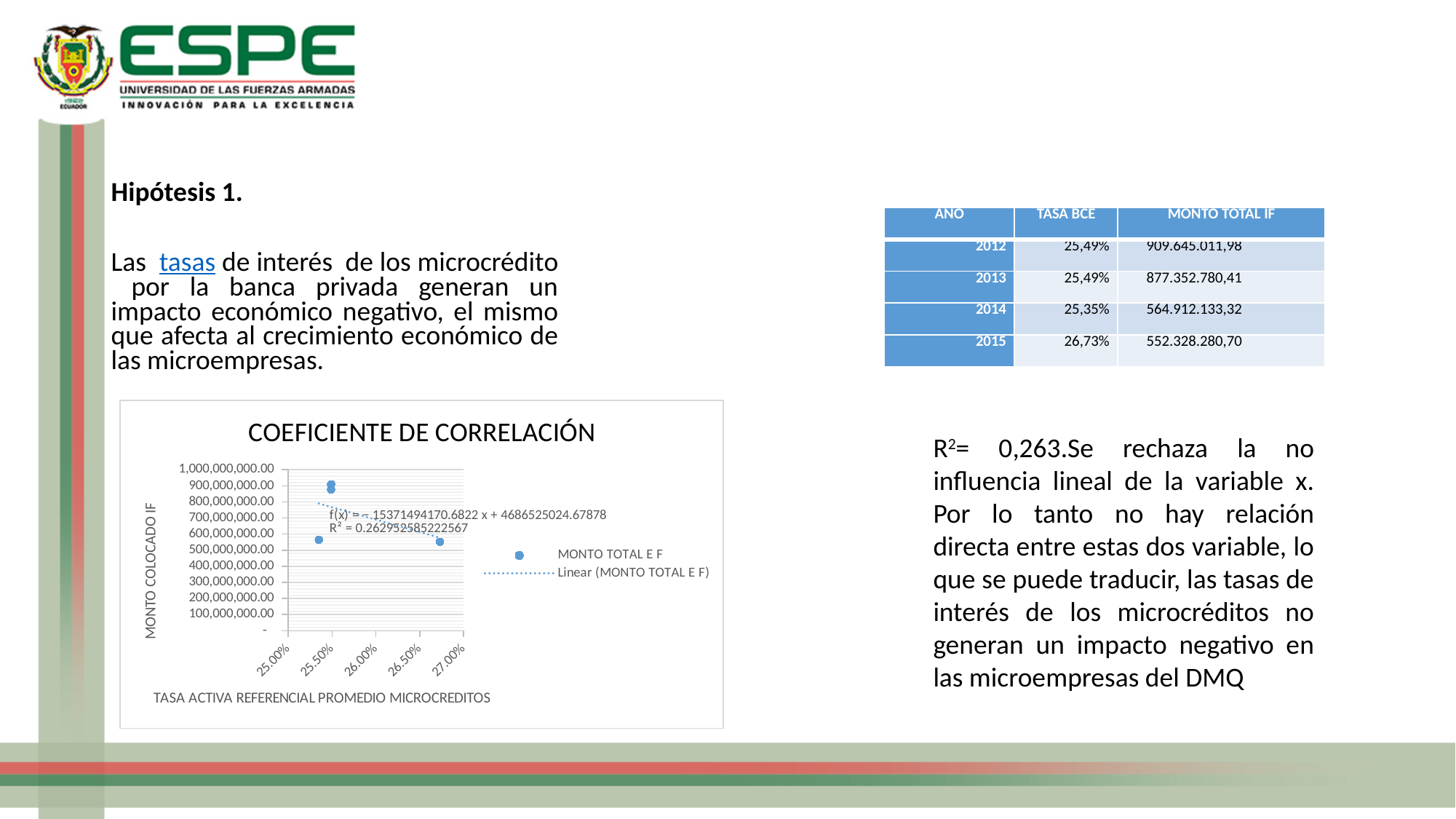
How many entries does the legend of the COEFICIENTE DE CORRELACIÓN chart list? 2 What is the trendline equation printed on the COEFICIENTE DE CORRELACIÓN chart? f(x) = -15371494170.6822 x + 4686525024.67878 In the COEFICIENTE DE CORRELACIÓN chart, is the value of the point near 26.73% on the x axis greater or less than 600,000,000.00? less What R² value is printed on the COEFICIENTE DE CORRELACIÓN chart? R² = 0.262952585222567 What is the highest value shown on the y axis of the COEFICIENTE DE CORRELACIÓN chart? 1,000,000,000.00 Does the linear trendline in the COEFICIENTE DE CORRELACIÓN chart rise or fall as the rate on the x axis increases? fall How many data points are plotted in the COEFICIENTE DE CORRELACIÓN chart? 4 What kind of chart is shown under the title COEFICIENTE DE CORRELACIÓN? scatter chart What is the title of the chart on the slide? COEFICIENTE DE CORRELACIÓN In the COEFICIENTE DE CORRELACIÓN chart, is the highest plotted point greater or less than 800,000,000.00? greater What is the lowest rate shown on the x axis of the COEFICIENTE DE CORRELACIÓN chart? 25.00% What is the label of the y axis of the COEFICIENTE DE CORRELACIÓN chart? MONTO COLOCADO IF